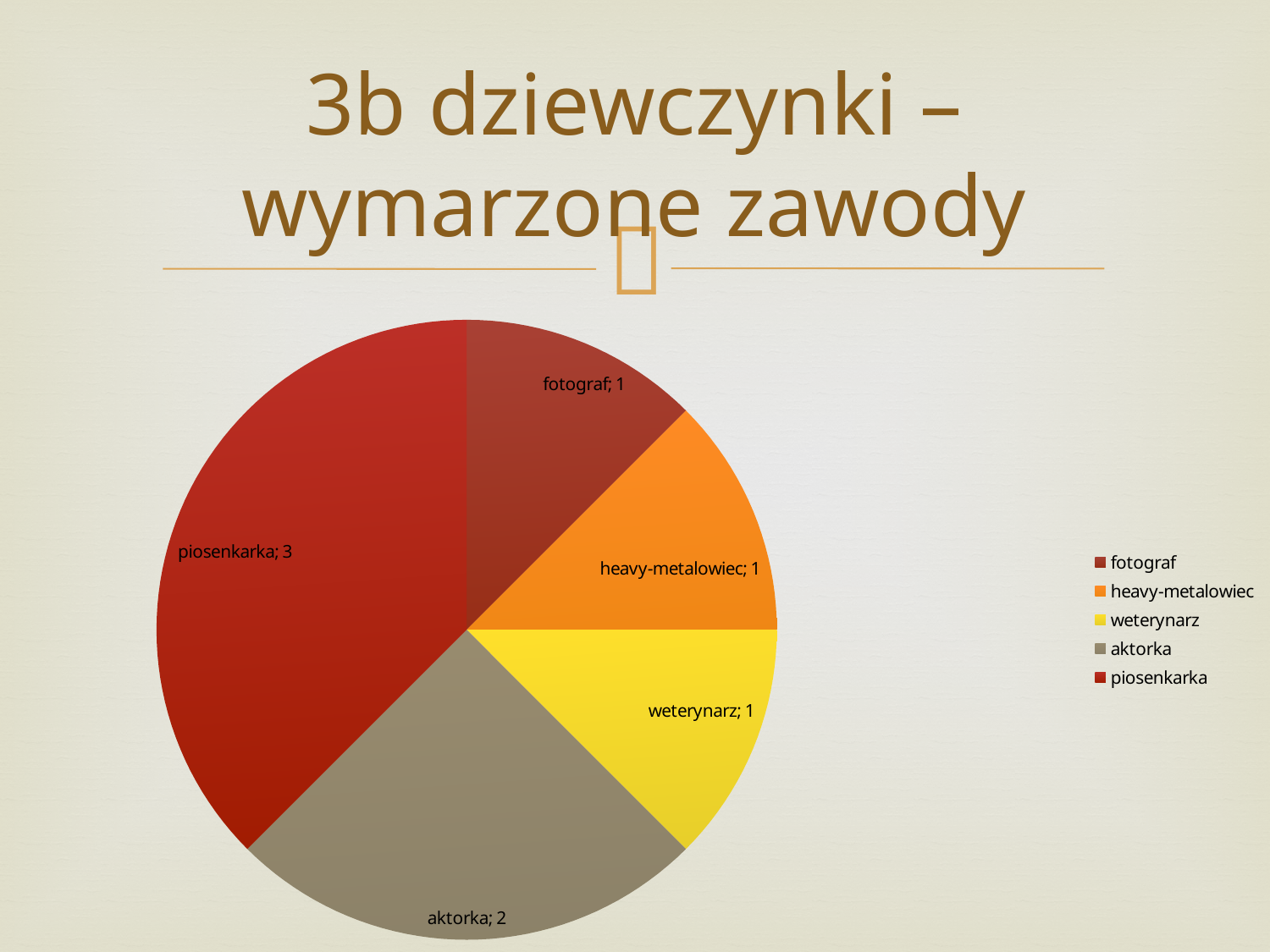
What kind of chart is shown on the slide? pie chart What share of the pie does the aktorka slice represent? 25% What share of the pie does the piosenkarka slice represent? 37.5% What is the difference between the values for piosenkarka and aktorka? 1 Which is larger, the value for aktorka or the value for fotograf? aktorka What is the value for weterynarz? 1 Which category has the largest slice of the pie? piosenkarka What is the value for aktorka? 2 What is the title of the slide containing the chart? 3b dziewczynki – wymarzone zawody How many categories does the pie chart have? 5 What is the value for piosenkarka? 3 How many entries does the legend list? 5